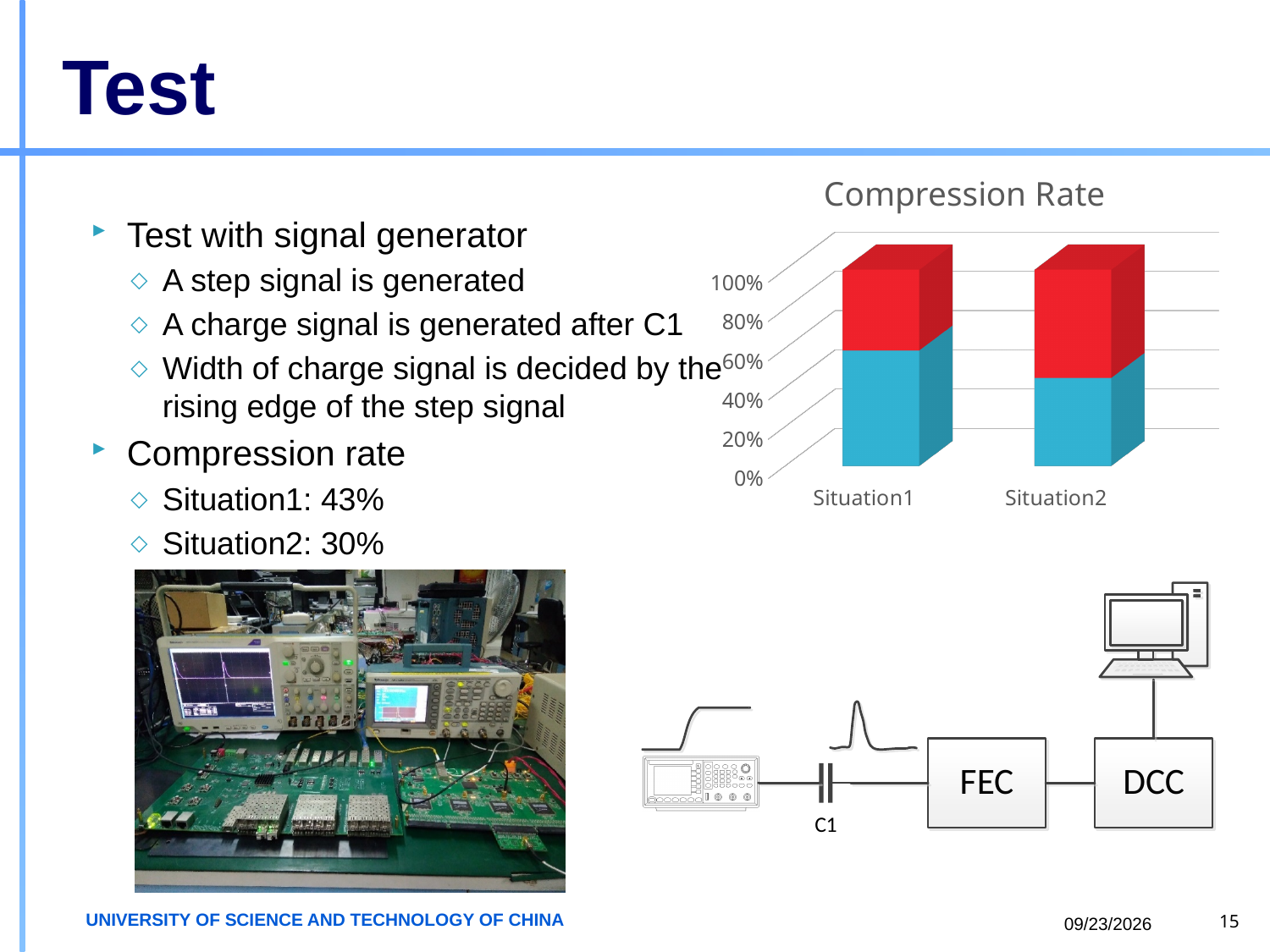
In the Compression Rate chart, which category has the larger blue (bottom) segment, Situation1 or Situation2? Situation1 In the Compression Rate chart, is the blue segment for Situation2 greater or less than 20%? greater How many categories are shown on the x axis of the Compression Rate chart? 2 What are the two category labels on the x axis of the Compression Rate chart? Situation1 and Situation2 What is the title of the chart on the slide? Compression Rate Does the blue segment rise or fall from Situation1 to Situation2 in the Compression Rate chart? fall What kind of chart is the Compression Rate chart? stacked bar chart In the Compression Rate chart, is the blue segment for Situation2 greater or less than 60%? less What is the highest value shown on the y axis of the Compression Rate chart? 100% In the Compression Rate chart, is the blue segment for Situation1 greater or less than 40%? greater In the Compression Rate chart, which category has the larger red (top) segment, Situation1 or Situation2? Situation2